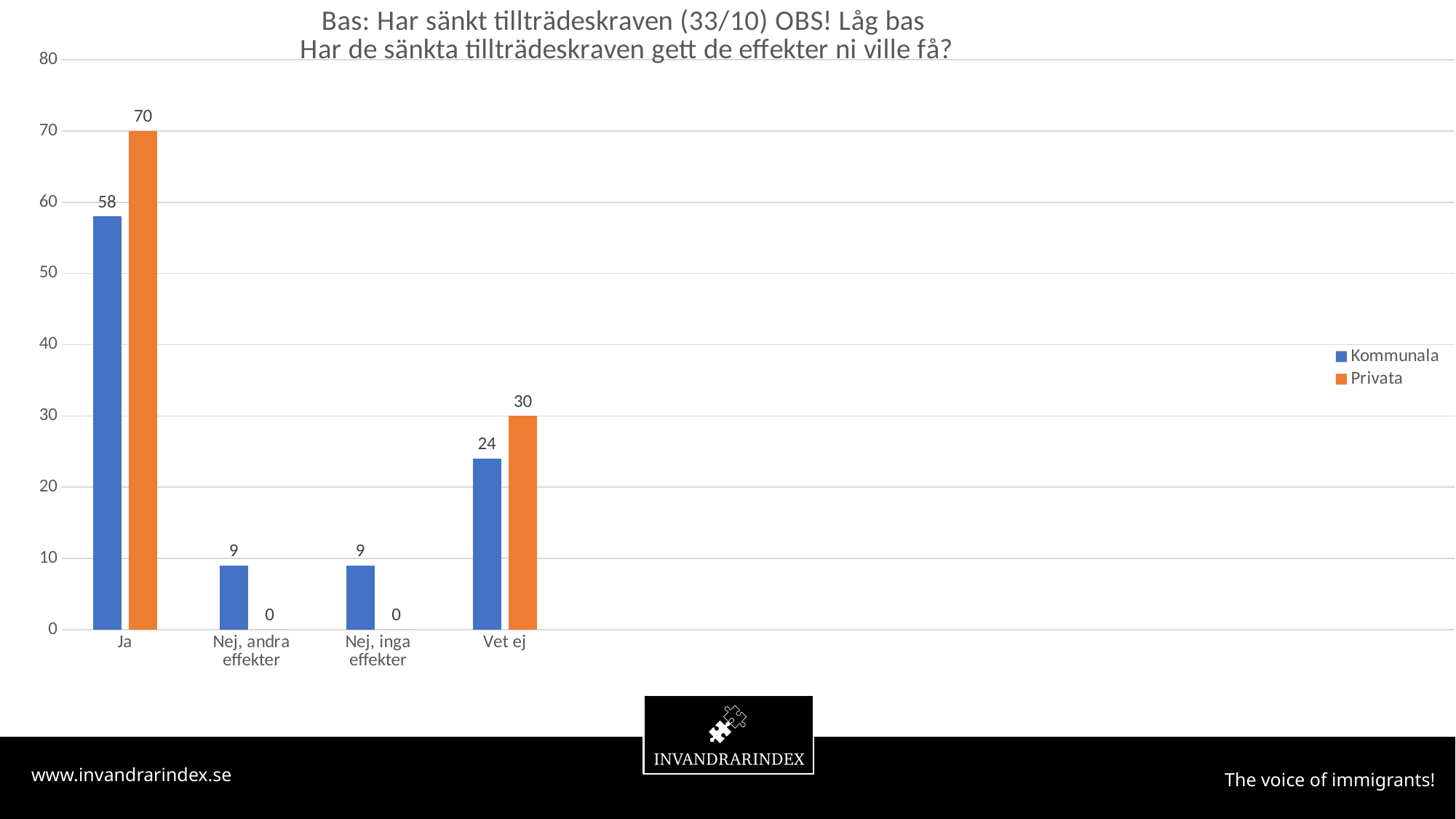
What kind of chart is shown on the slide? Bar chart What is the difference between the Kommunala values for Ja and Vet ej? 34 In the Vet ej category, which series has the larger value, Kommunala or Privata? Privata Which category has the highest value for the Privata series? Ja How many series does the legend list? 2 Which category has the lowest value for the Kommunala series? Nej, andra effekter and Nej, inga effekter (both 9) How many categories are shown on the x axis? 4 What is the value for Privata in the Nej, inga effekter category? 0 Which colour represents the Privata series? Orange What is the value for Kommunala in the Ja category? 58 What is the difference between the Privata and Kommunala values in the Ja category? 12 What is the value for Privata in the Vet ej category? 30